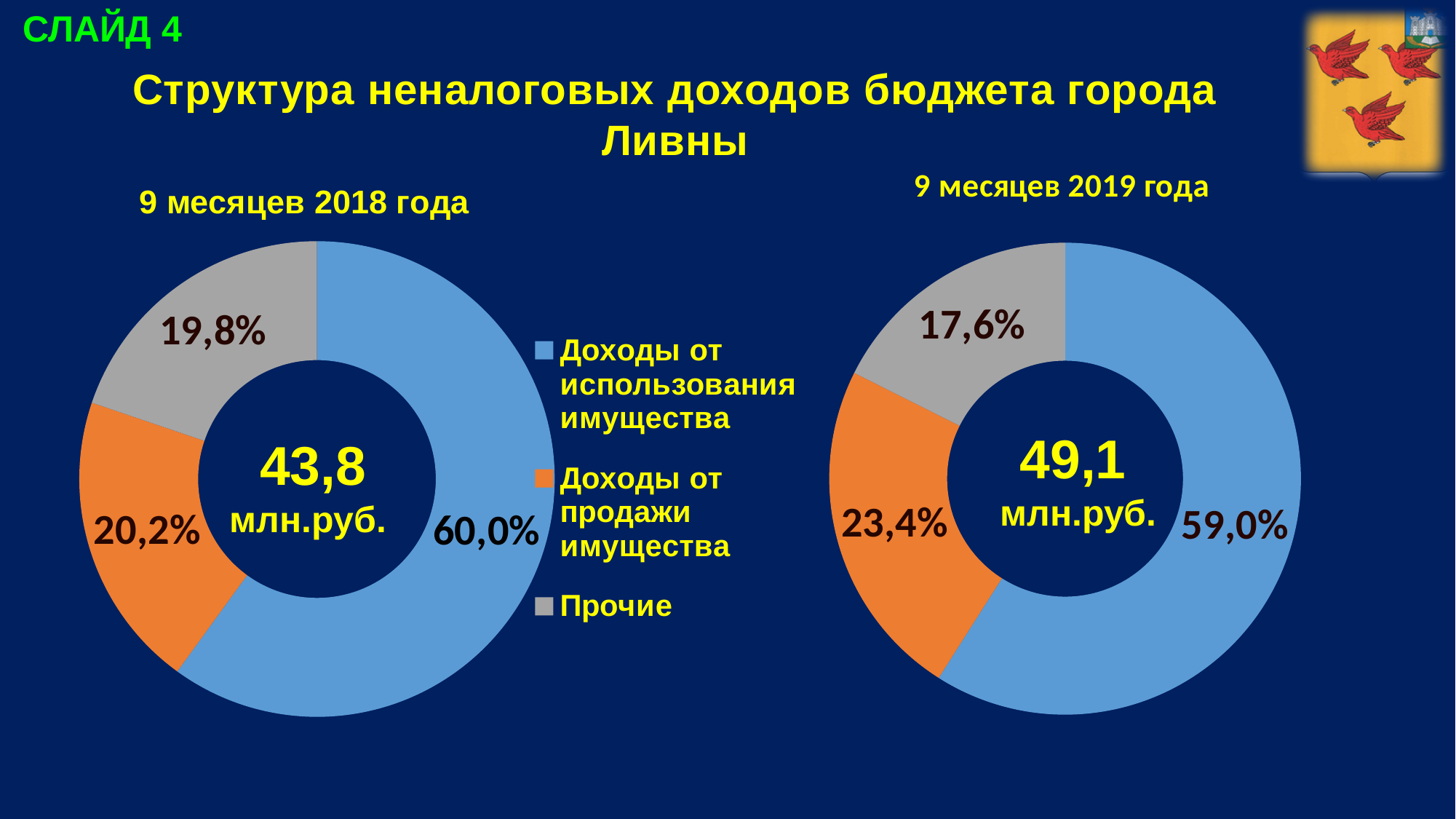
What type of chart is used for '9 месяцев 2018 года'? Pie (doughnut) chart Which is larger: the 'Доходы от продажи имущества' share in the '9 месяцев 2018 года' chart or in the '9 месяцев 2019 года' chart? 9 месяцев 2019 года What total value is shown in the centre of the '9 месяцев 2018 года' chart? 43,8 млн.руб. In the '9 месяцев 2018 года' chart, what share is labelled for 'Прочие'? 19,8% In the '9 месяцев 2019 года' chart, which category has the largest share? Доходы от использования имущества What total value is shown in the centre of the '9 месяцев 2019 года' chart? 49,1 млн.руб. In the '9 месяцев 2018 года' chart, which category has the smallest share? Прочие In the '9 месяцев 2019 года' chart, what share is labelled for 'Доходы от продажи имущества'? 23,4% In the '9 месяцев 2019 года' chart, what share is labelled for 'Прочие'? 17,6% In the '9 месяцев 2018 года' chart, what share is labelled for 'Доходы от использования имущества'? 60,0% How many categories does the legend list for the charts? 3 In the '9 месяцев 2019 года' chart, what is the difference between the shares of 'Доходы от продажи имущества' and 'Прочие'? 5,8%